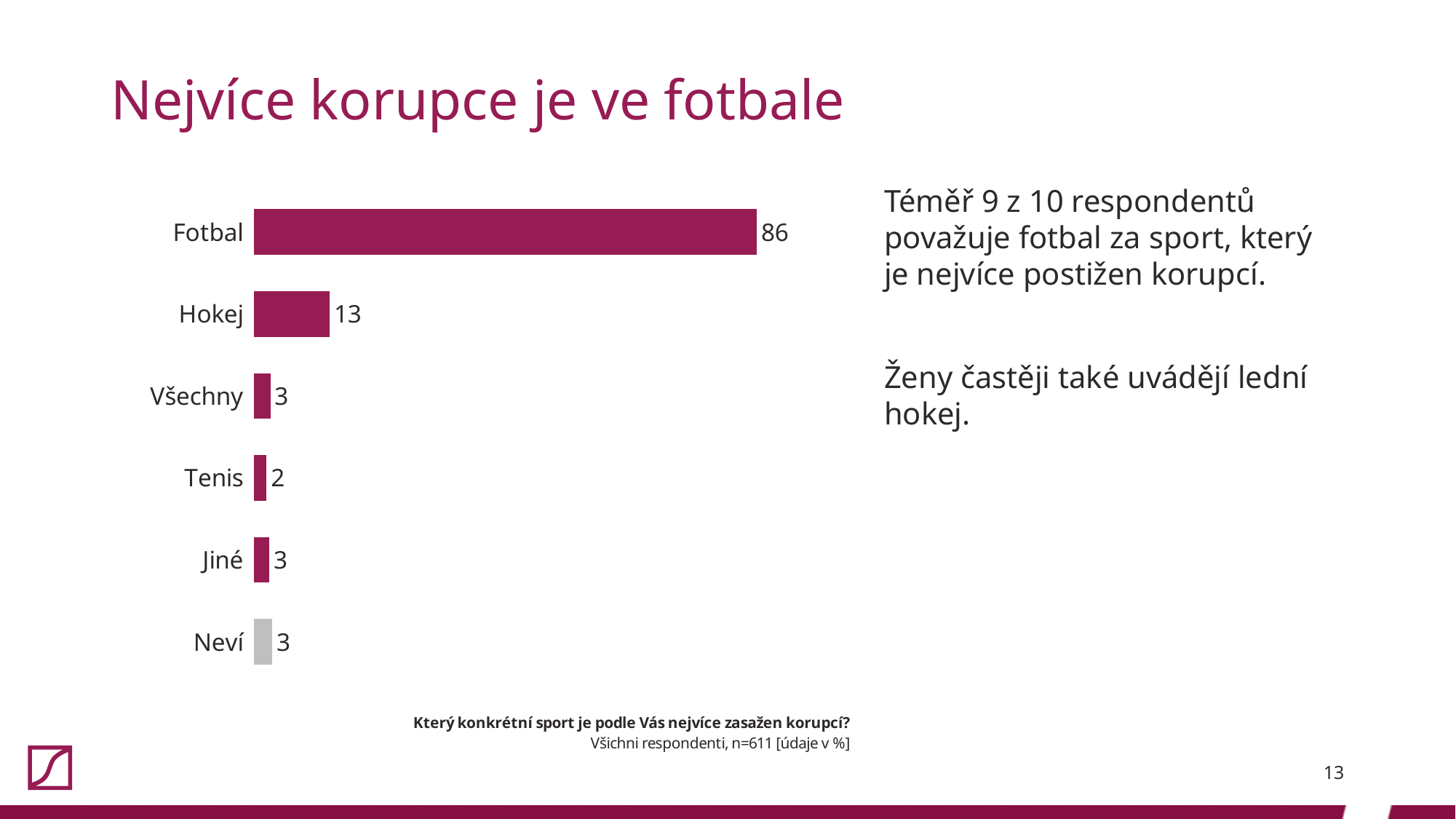
What is the value for Fotbal? 86 What is the difference between the values for Fotbal and Hokej? 73 Which category has the lowest value? Tenis Which category has the highest value? Fotbal Which is larger, the value for Hokej or the value for Jiné? Hokej What is the difference between the values for Hokej and Tenis? 11 What is the value for Hokej? 13 What kind of chart is shown on the slide? bar chart What is the value for Všechny? 3 What is the value for Tenis? 2 Which category's bar is coloured grey instead of purple? Neví How many categories are shown in the chart? 6